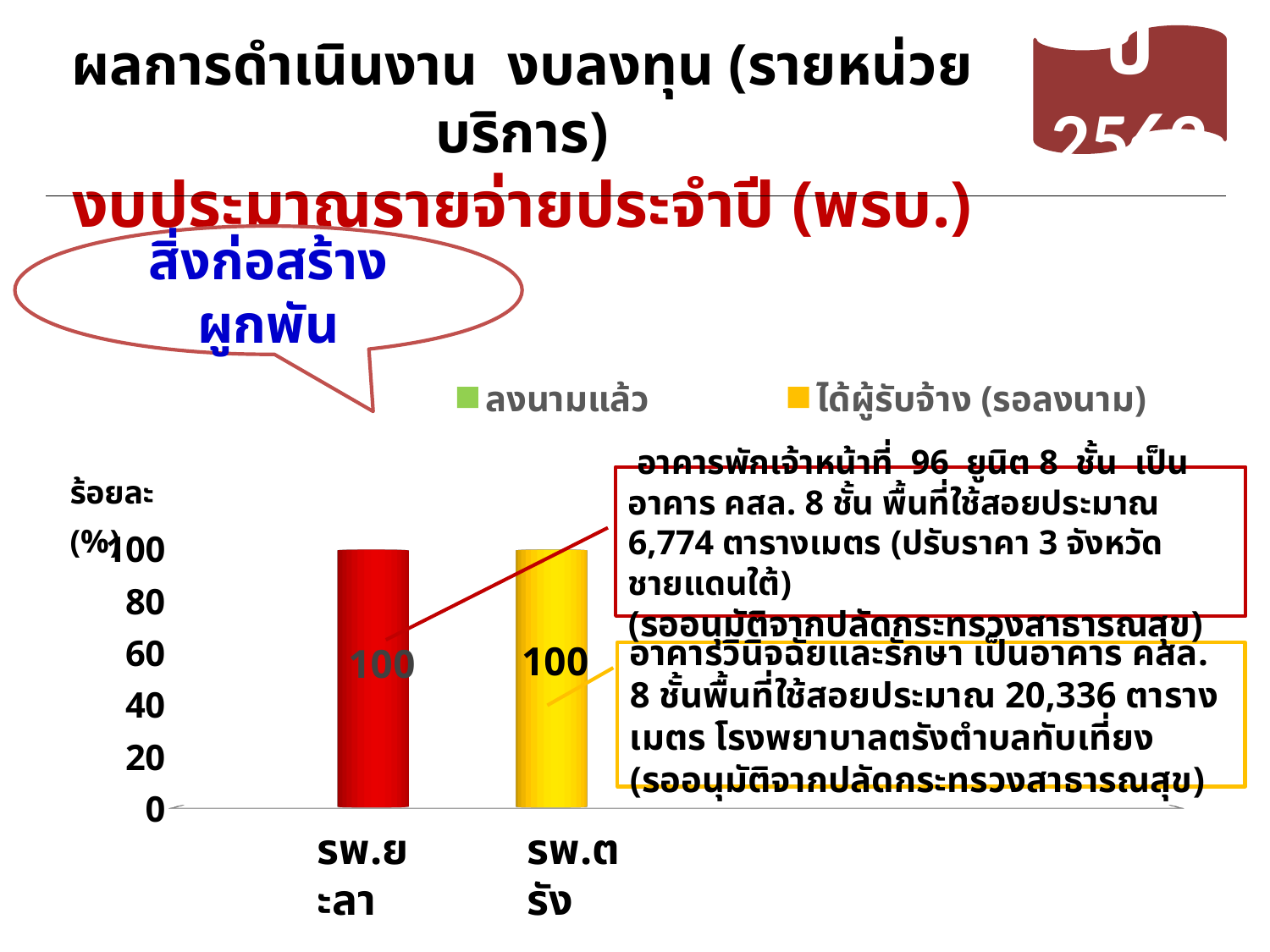
Is the value for รพ.ยะลา greater or less than 80? greater What kind of chart is shown on the slide? bar chart What are the two legend entries of the chart? ลงนามแล้ว and ได้ผู้รับจ้าง (รอลงนาม) Is the value for รพ.ตรัง greater or less than 60? greater How many series does the legend list? 2 What is the label of the y axis? ร้อยละ (%) What is the highest tick value shown on the y axis? 100 What is the value for รพ.ยะลา? 100 What is the value for รพ.ตรัง? 100 What is the difference between the values for รพ.ยะลา and รพ.ตรัง? 0 How many categories are shown on the x axis of the chart? 2